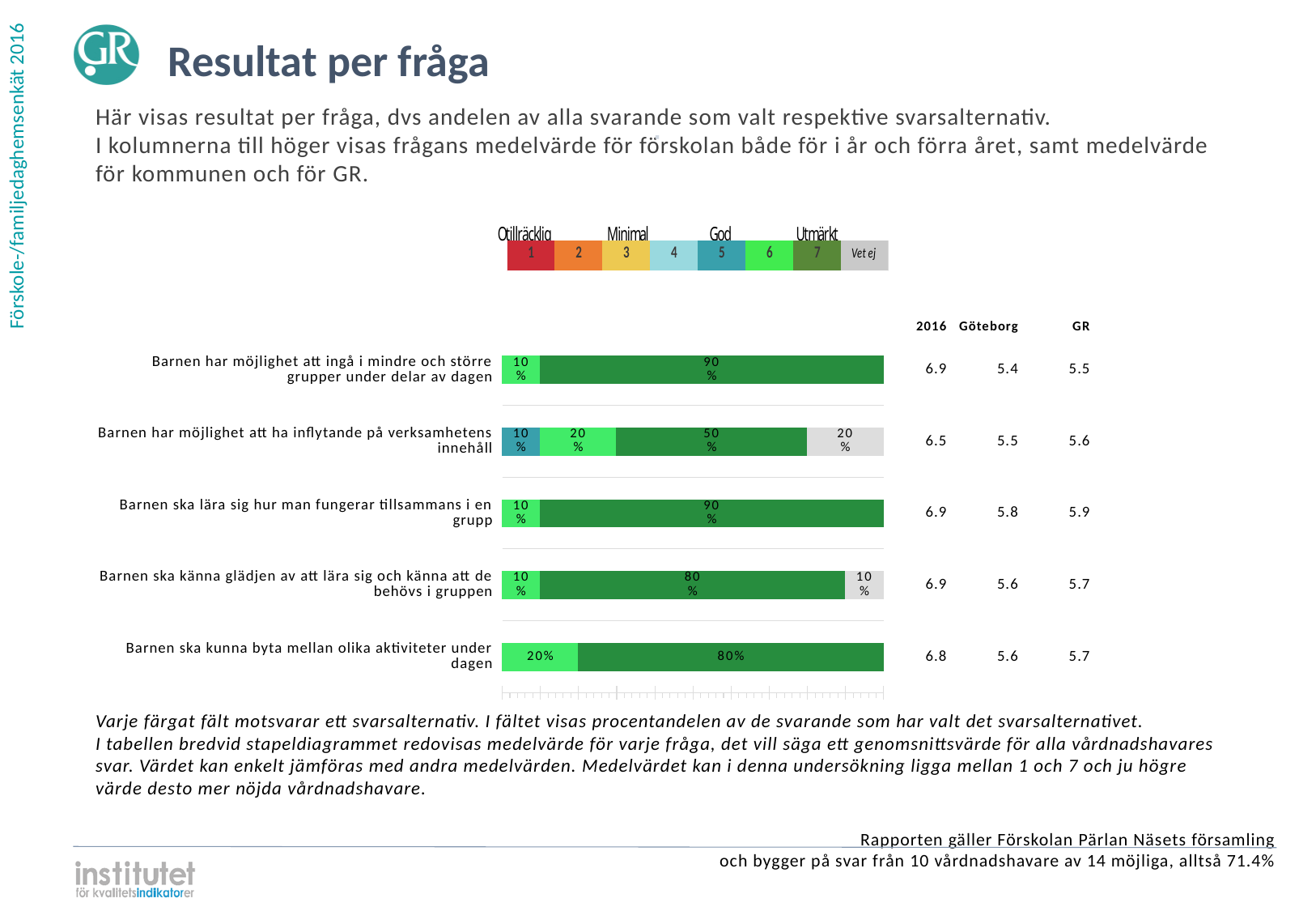
What percentage of respondents chose answer option 6 (light green) for 'Barnen ska kunna byta mellan olika aktiviteter under dagen'? 20% What is the GR mean value shown for 'Barnen ska lära sig hur man fungerar tillsammans i en grupp'? 5.9 For 'Barnen ska känna glädjen av att lära sig och känna att de behövs i gruppen', which is larger: the share for option 7 or the share for 'Vet ej'? Option 7 What is the 2016 mean value shown for 'Barnen har möjlighet att ha inflytande på verksamhetens innehåll'? 6.5 Which question has the lowest share of respondents choosing answer option 7 (dark green)? Barnen har möjlighet att ha inflytande på verksamhetens innehåll How many answer options does the legend above the chart list? 8 How many questions (categories) are shown in the bar chart? 5 What percentage of respondents chose answer option 7 (dark green) for 'Barnen har möjlighet att ingå i mindre och större grupper under delar av dagen'? 90% What percentage of respondents answered 'Vet ej' for 'Barnen har möjlighet att ha inflytande på verksamhetens innehåll'? 20% What is the total of the stacked bar for 'Barnen ska kunna byta mellan olika aktiviteter under dagen'? 100% What is the difference in percentage points between the option 7 share and the option 6 share for 'Barnen ska lära sig hur man fungerar tillsammans i en grupp'? 80 percentage points What kind of chart is used to show the results per question? Stacked bar chart